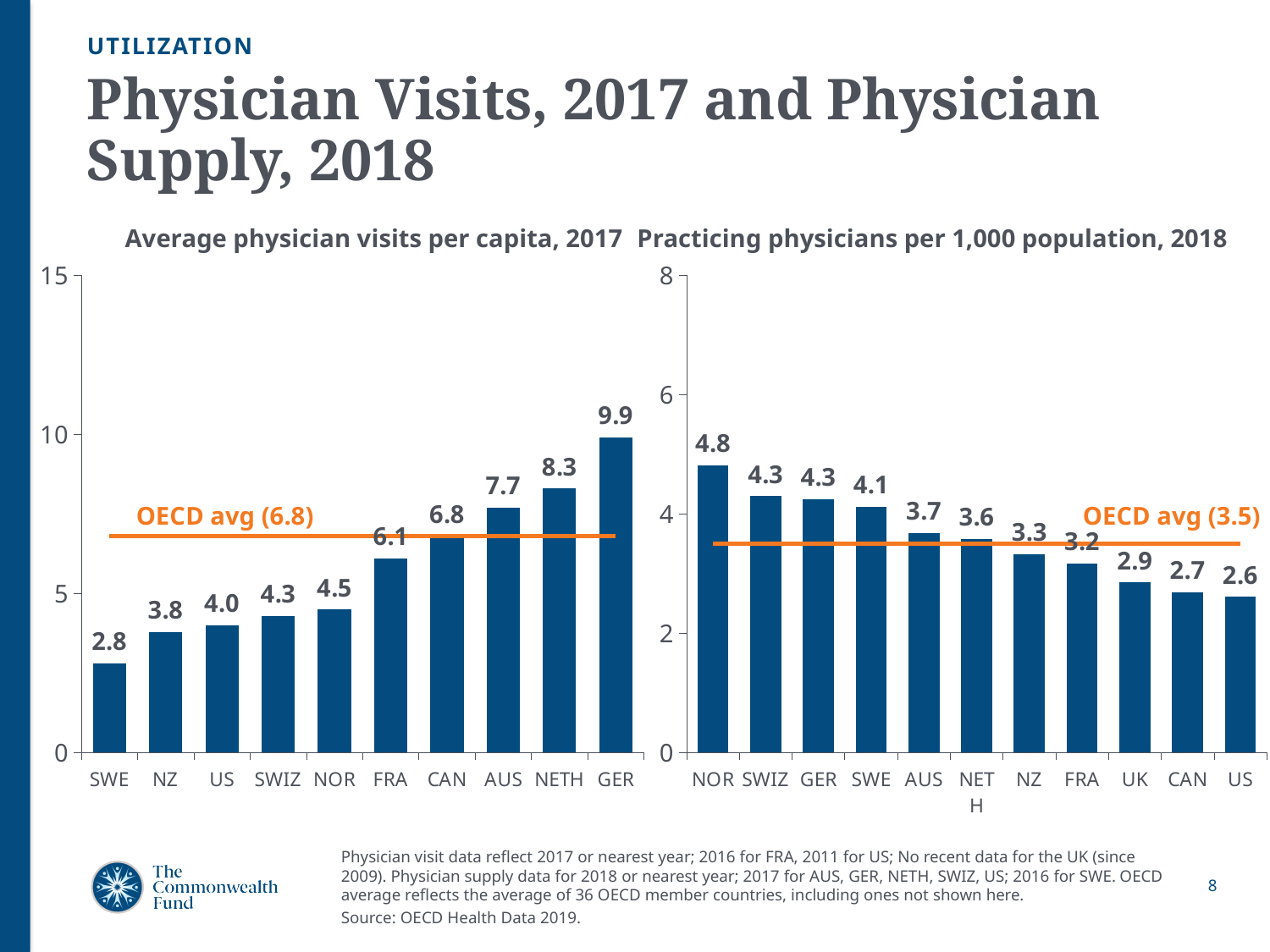
In the 'Practicing physicians per 1,000 population, 2018' chart, what is the value for NOR? 4.8 What kind of chart is the 'Average physician visits per capita, 2017' chart? bar chart In the 'Practicing physicians per 1,000 population, 2018' chart, do the values rise or fall from left to right? fall In the 'Practicing physicians per 1,000 population, 2018' chart, which country has the lowest value? US In the 'Practicing physicians per 1,000 population, 2018' chart, which is larger, the value for SWE or the value for AUS? SWE In the 'Average physician visits per capita, 2017' chart, what is the difference between NETH and CAN? 1.5 In the 'Average physician visits per capita, 2017' chart, what is the value for GER? 9.9 In the 'Average physician visits per capita, 2017' chart, what OECD average value is shown on the orange line? 6.8 In the 'Average physician visits per capita, 2017' chart, which country has the lowest value? SWE In the 'Practicing physicians per 1,000 population, 2018' chart, what is the difference between NOR and US? 2.2 In the 'Practicing physicians per 1,000 population, 2018' chart, how many countries are shown? 11 In the 'Average physician visits per capita, 2017' chart, how many countries are shown? 10